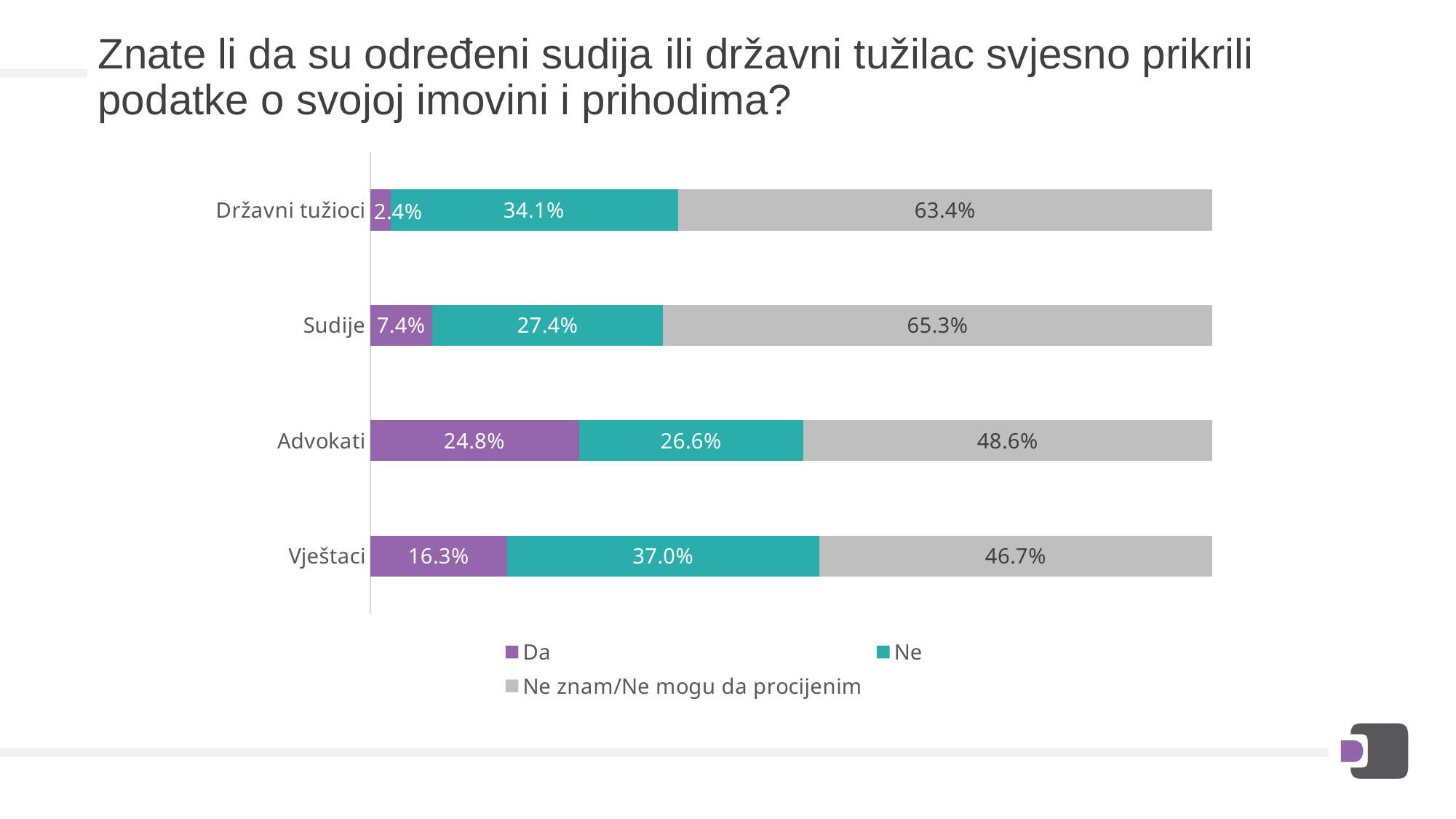
What kind of chart is shown on the slide? Stacked bar chart How many categories are shown on the chart? 4 How many series does the legend list? 3 What is the "Ne" value for Vještaci? 37.0% Which is larger: the "Da" value for Vještaci or the "Da" value for Sudije? Vještaci What is the "Da" value for Državni tužioci? 2.4% Which category has the lowest "Ne znam/Ne mogu da procijenim" value? Vještaci What is the "Ne znam/Ne mogu da procijenim" value for Sudije? 65.3% What percentage of Advokati answered "Da"? 24.8% Which category has the highest "Da" value? Advokati What is the difference between the "Ne" values for Vještaci and Sudije? 9.6% Which colour represents the "Ne" series in the chart? Teal